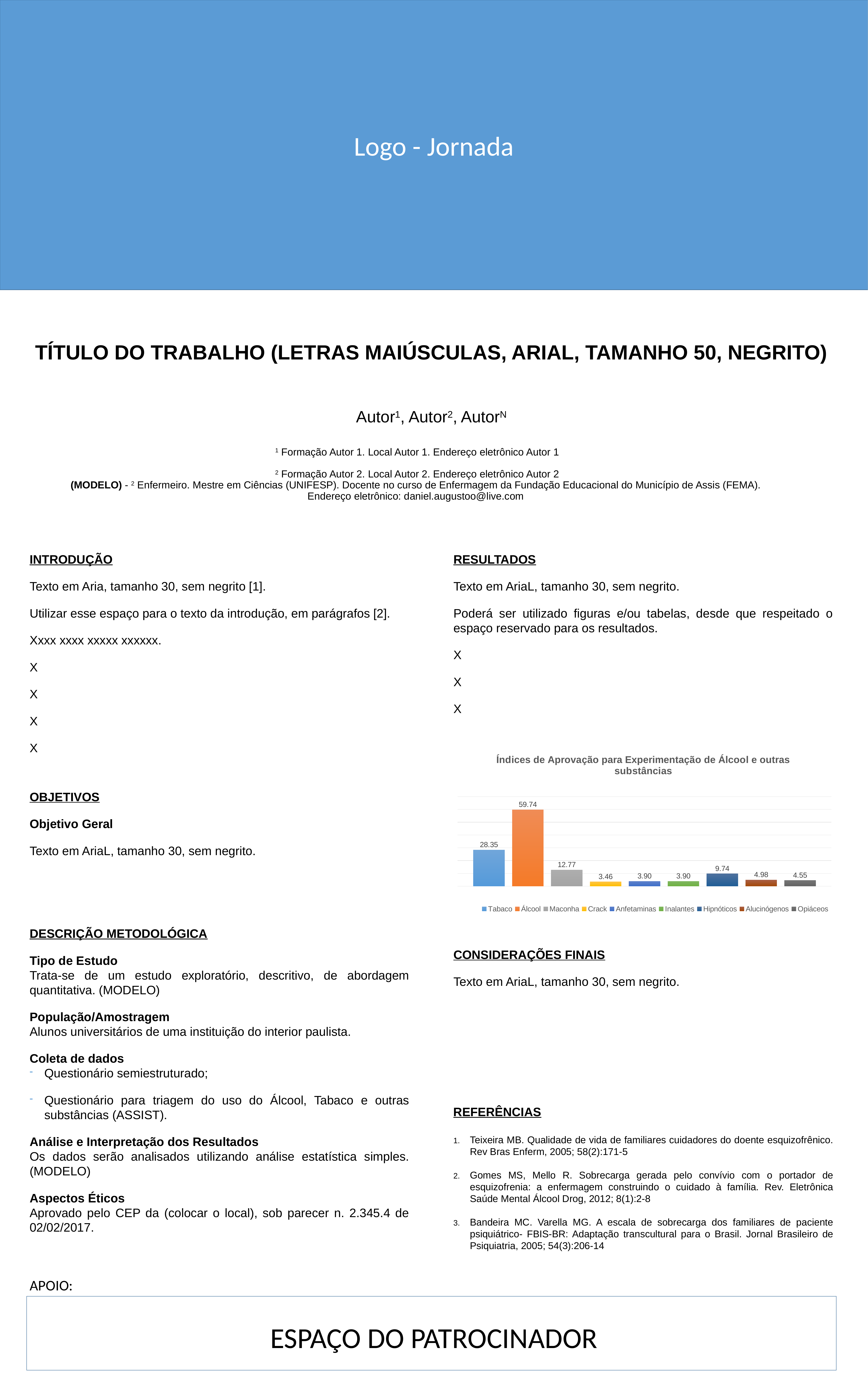
What is the difference between the values for Álcool and Tabaco? 31.39 How many bars are shown in the chart? 9 Which substance has the lowest value? Crack What is the value for Álcool? 59.74 How many entries does the legend list? 9 Which is larger, the value for Alucinógenos or the value for Opiáceos? Alucinógenos What is the value for Maconha? 12.77 What is the value for Tabaco? 28.35 Which substance has the highest value? Álcool What kind of chart is shown on the slide? Bar chart What is the value for Hipnóticos? 9.74 What is the value for Crack? 3.46